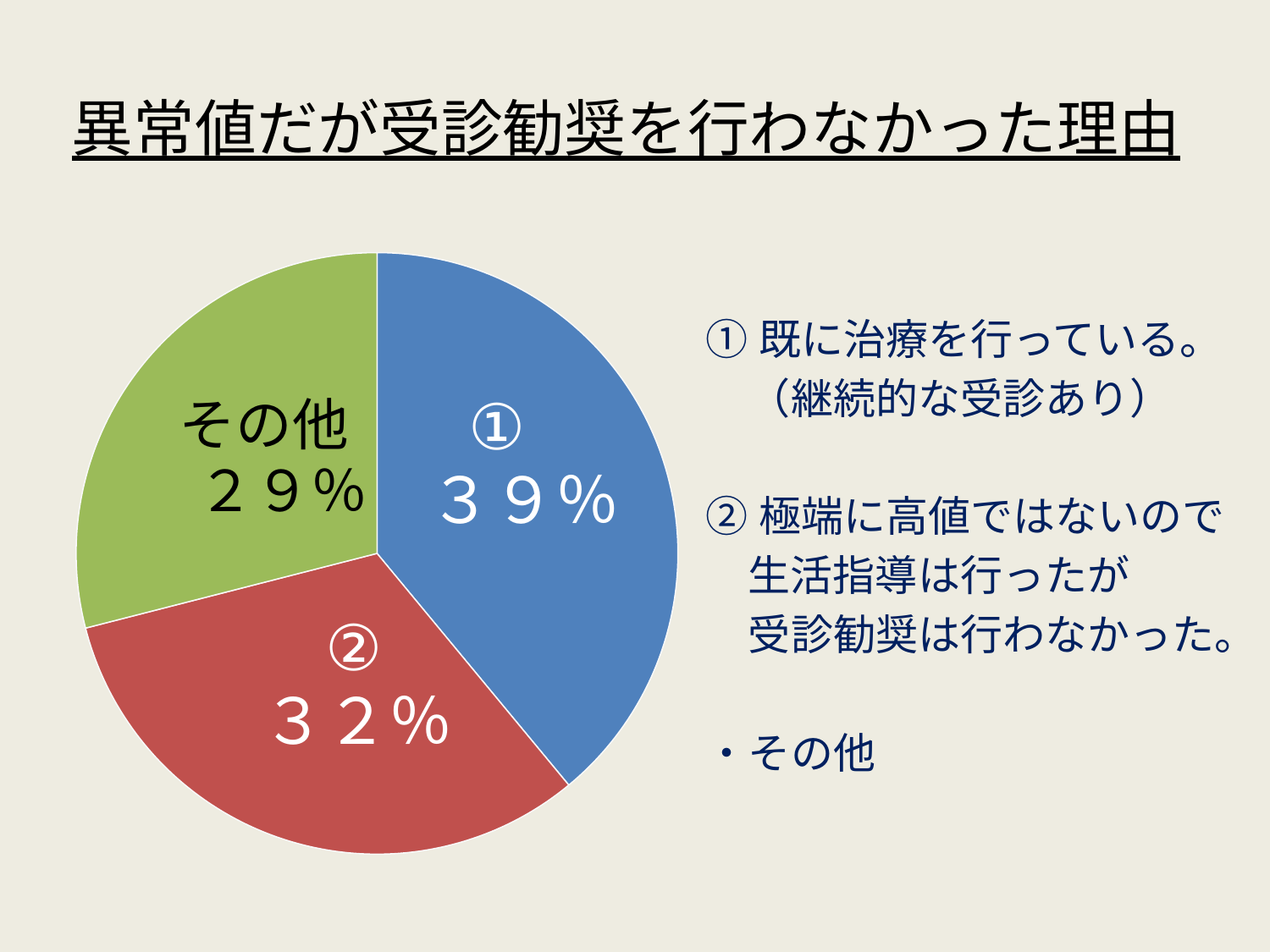
How many slices does the pie chart have? 3 What is the difference in percentage points between slice ① and slice ②? 7 Which slice has the smallest share? その他 What colour is the slice labelled ②? red What percentage is shown for slice ①? ３９％ Which slice has the largest share? ① What is the difference in percentage points between slice ② and the その他 slice? 3 What kind of chart is shown on the slide? pie chart What percentage is shown for slice ②? ３２％ What percentage is shown for the その他 slice? ２９％ Which is larger, slice ① or the その他 slice? ① What is the title of the slide? 異常値だが受診勧奨を行わなかった理由